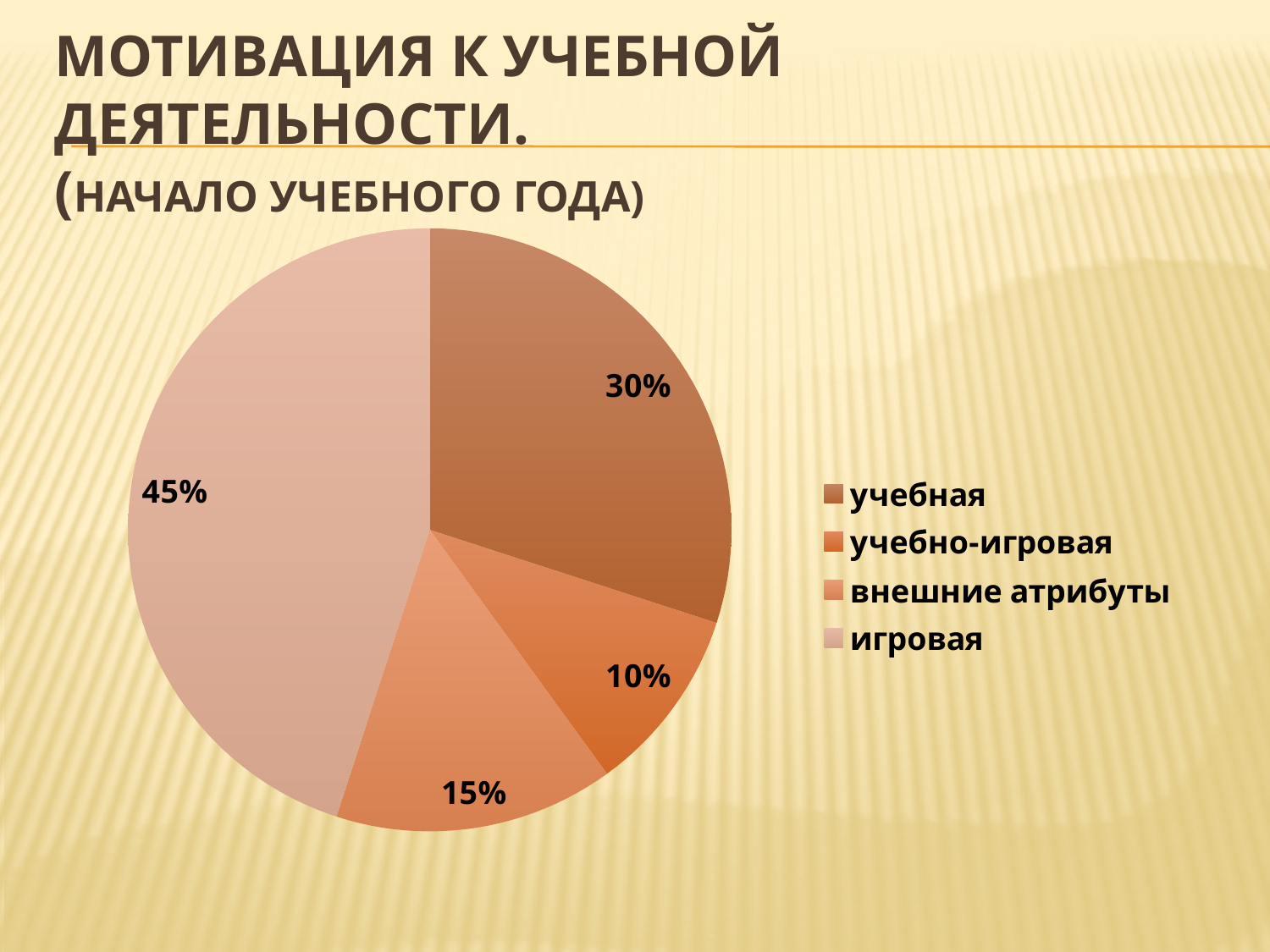
What is the difference between the values for игровая and учебная? 15% Which category has the largest share of the pie? игровая What kind of chart is shown on the slide? pie chart Which category has the smallest share of the pie? учебно-игровая Which is larger, the value for внешние атрибуты or the value for учебно-игровая? внешние атрибуты What is the value for учебная? 30% What is the value for игровая? 45% What is the difference between the values for учебная and внешние атрибуты? 15% How many entries does the legend list? 4 What is the value for внешние атрибуты? 15% How many slices does the pie chart have? 4 What is the value for учебно-игровая? 10%